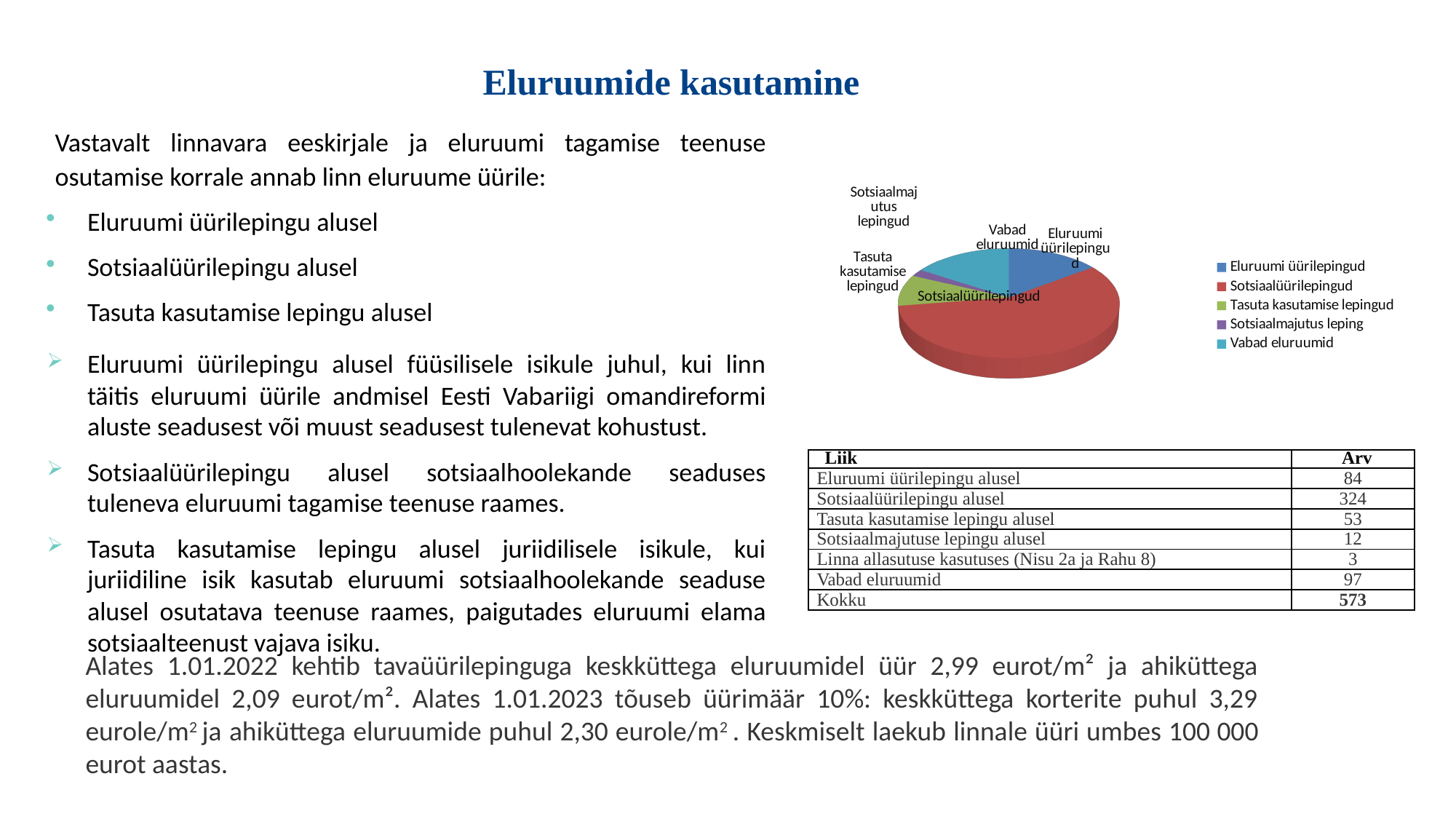
Which category has the smallest slice in the pie chart? Sotsiaalmajutus leping Which slice is larger in the pie chart: Sotsiaalüürilepingud or Vabad eluruumid? Sotsiaalüürilepingud What colour is the Sotsiaalüürilepingud slice in the pie chart? red Which slice is larger in the pie chart: Tasuta kasutamise lepingud or Sotsiaalmajutus leping? Tasuta kasutamise lepingud Which legend entry is shown in green in the pie chart? Tasuta kasutamise lepingud Which category has the largest slice in the pie chart? Sotsiaalüürilepingud How many slices does the pie chart have? 5 How many entries does the pie chart's legend list? 5 Which slice is larger in the pie chart: Vabad eluruumid or Tasuta kasutamise lepingud? Vabad eluruumid What kind of chart is shown on the slide? pie chart